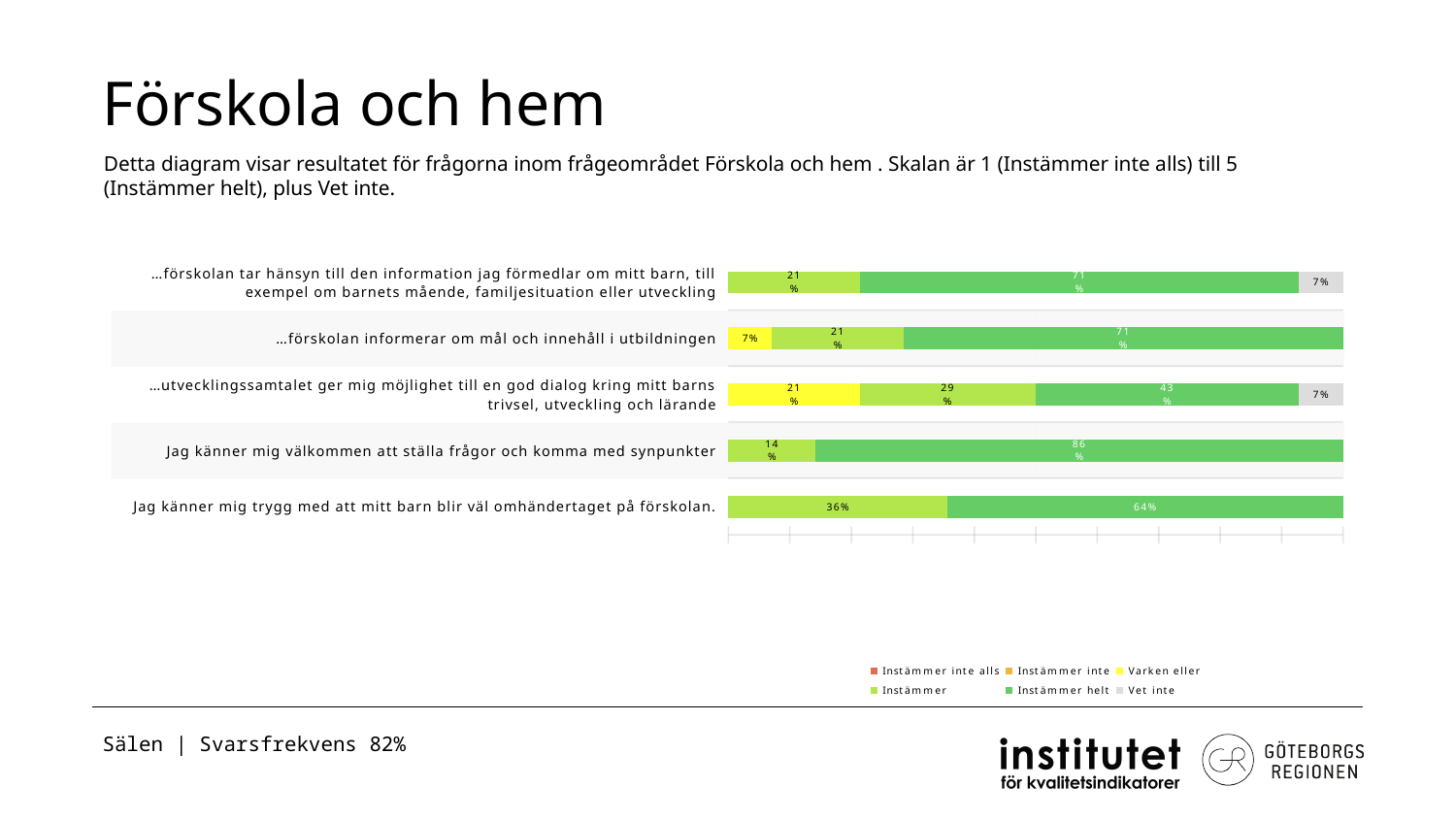
How many series does the legend list? 6 What is the 'Instämmer' value for 'Jag känner mig trygg med att mitt barn blir väl omhändertaget på förskolan.'? 36% What is the 'Instämmer helt' value for 'Jag känner mig välkommen att ställa frågor och komma med synpunkter'? 86% Which is larger for '…utvecklingssamtalet ger mig möjlighet till en god dialog kring mitt barns trivsel, utveckling och lärande': the 'Instämmer' value or the 'Instämmer helt' value? Instämmer helt How many statements (categories) are plotted in the chart? 5 What is the title of the slide containing the chart? Förskola och hem Which statement has the lowest 'Instämmer helt' value? …utvecklingssamtalet ger mig möjlighet till en god dialog kring mitt barns trivsel, utveckling och lärande Which statement has the highest 'Instämmer helt' value? Jag känner mig välkommen att ställa frågor och komma med synpunkter What is the 'Varken eller' value for '…förskolan informerar om mål och innehåll i utbildningen'? 7% What is the 'Vet inte' value for '…utvecklingssamtalet ger mig möjlighet till en god dialog kring mitt barns trivsel, utveckling och lärande'? 7% What is the difference between the 'Instämmer helt' value (64%) and the 'Instämmer' value (36%) for 'Jag känner mig trygg med att mitt barn blir väl omhändertaget på förskolan.'? 28% What kind of chart is shown on the slide? Stacked bar chart